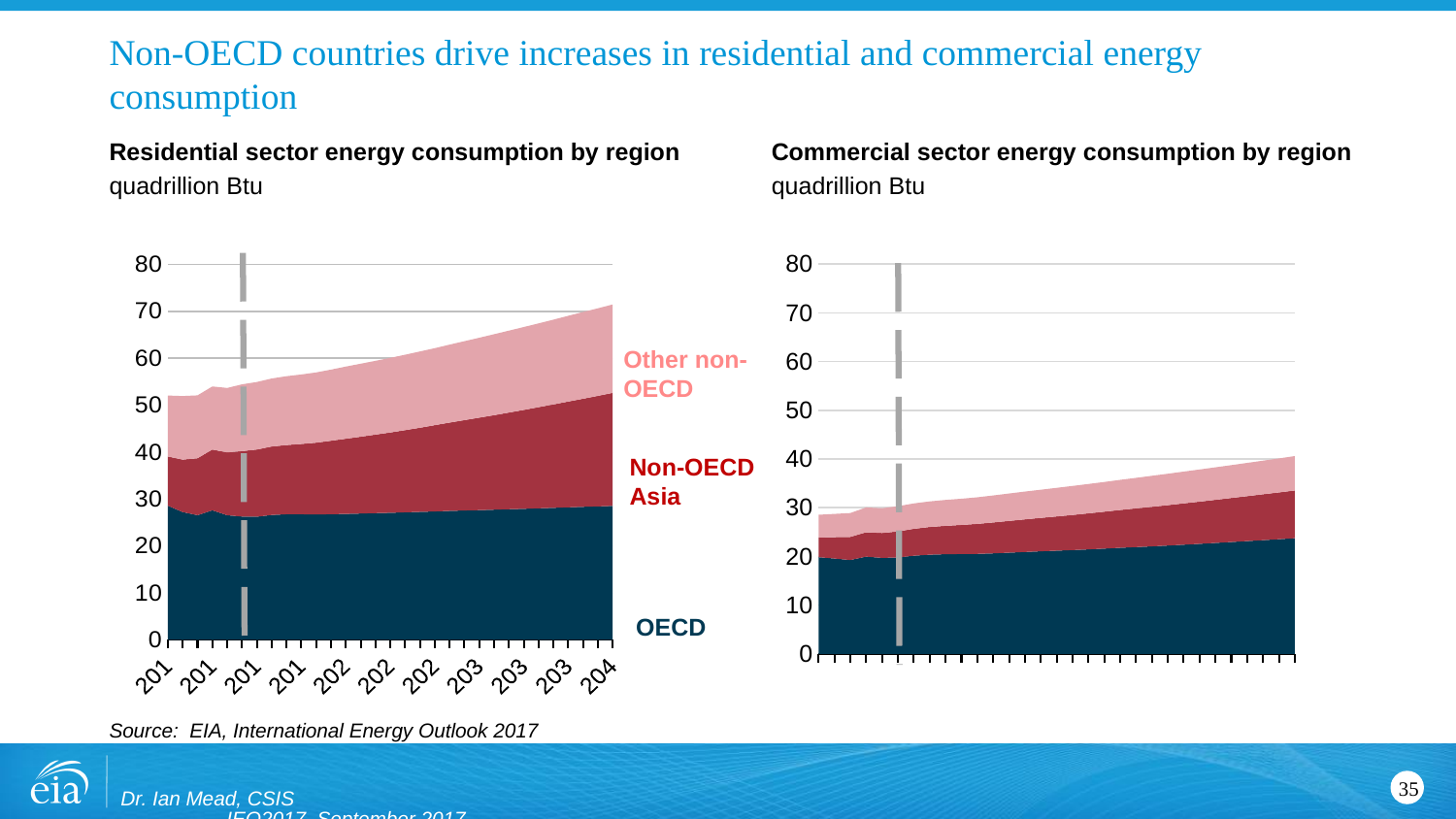
At the end of the projection period, which is larger: total residential sector consumption or total commercial sector consumption? residential In the Commercial sector energy consumption by region chart, does total consumption rise or fall over the projection period? rise In the Residential sector energy consumption by region chart, is total consumption at the end of the period greater or less than 60 quadrillion Btu? greater In the Residential sector energy consumption by region chart, does total consumption rise or fall over the projection period? rise In the Residential sector energy consumption by region chart, which region is plotted at the bottom of the stack? OECD What type of chart is the Residential sector energy consumption by region chart? stacked area chart How many regions (series) are shown in the Residential sector energy consumption by region chart? 3 In the Commercial sector energy consumption by region chart, is total consumption at the end of the period greater or less than 30 quadrillion Btu? greater In the Residential sector energy consumption by region chart, which region accounts for the largest share of consumption? OECD In the Residential sector energy consumption by region chart, is OECD consumption at the end of the period greater or less than 40 quadrillion Btu? less What unit is used on both charts? quadrillion Btu